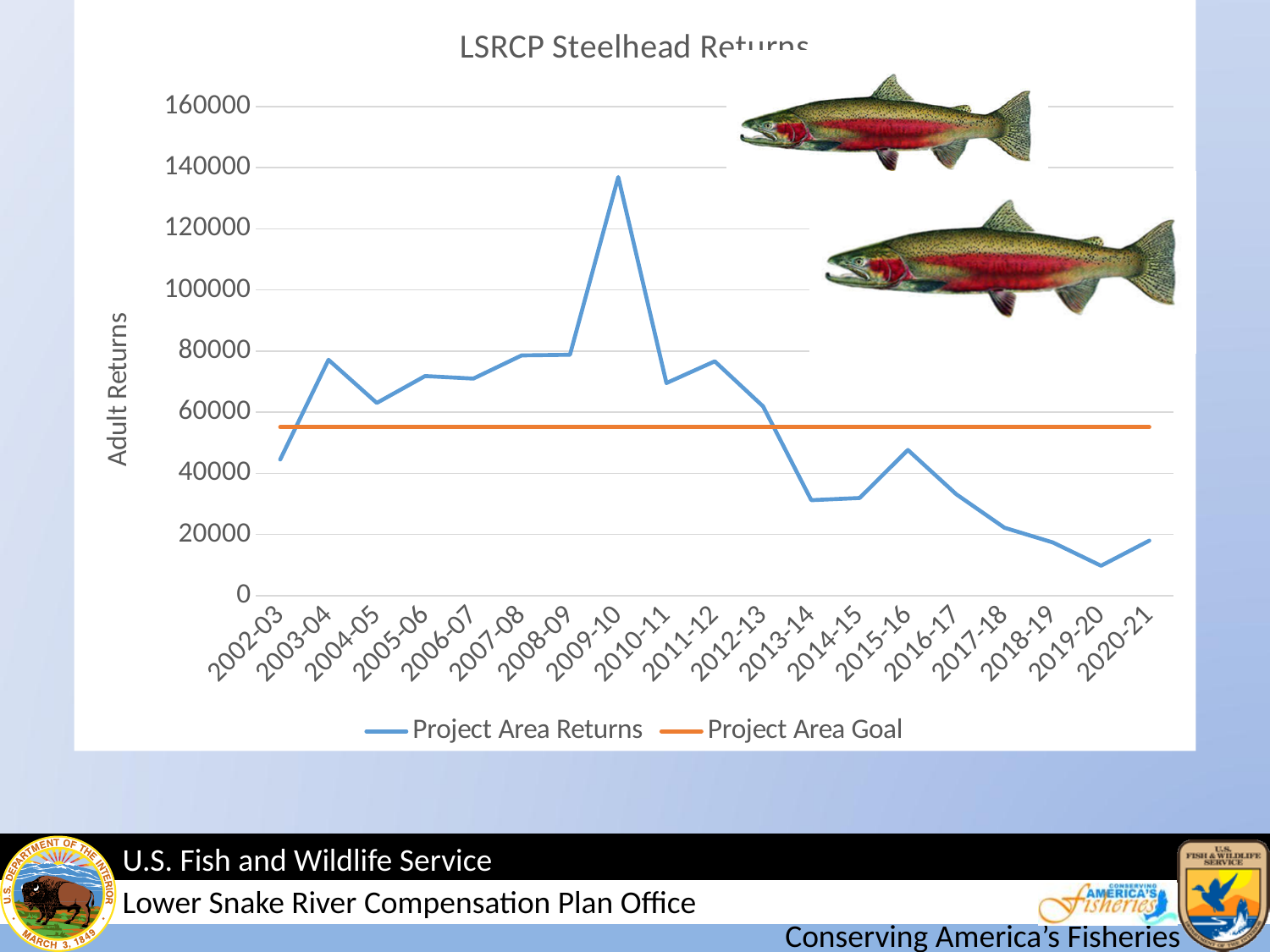
Do Project Area Returns rise or fall from 2011-12 to 2019-20? fall How many series does the legend list? 2 In which season were Project Area Returns lowest? 2019-20 Is the Project Area Goal line greater or less than 60000? less What kind of chart is shown on the slide? line chart Is the value of Project Area Returns for 2002-03 greater or less than 60000? less How many seasons are shown along the x axis? 19 Is the value of Project Area Returns for 2019-20 greater or less than 20000? less Which season had higher Project Area Returns, 2003-04 or 2004-05? 2003-04 What is the label on the vertical axis? Adult Returns In which season did Project Area Returns reach their highest value? 2009-10